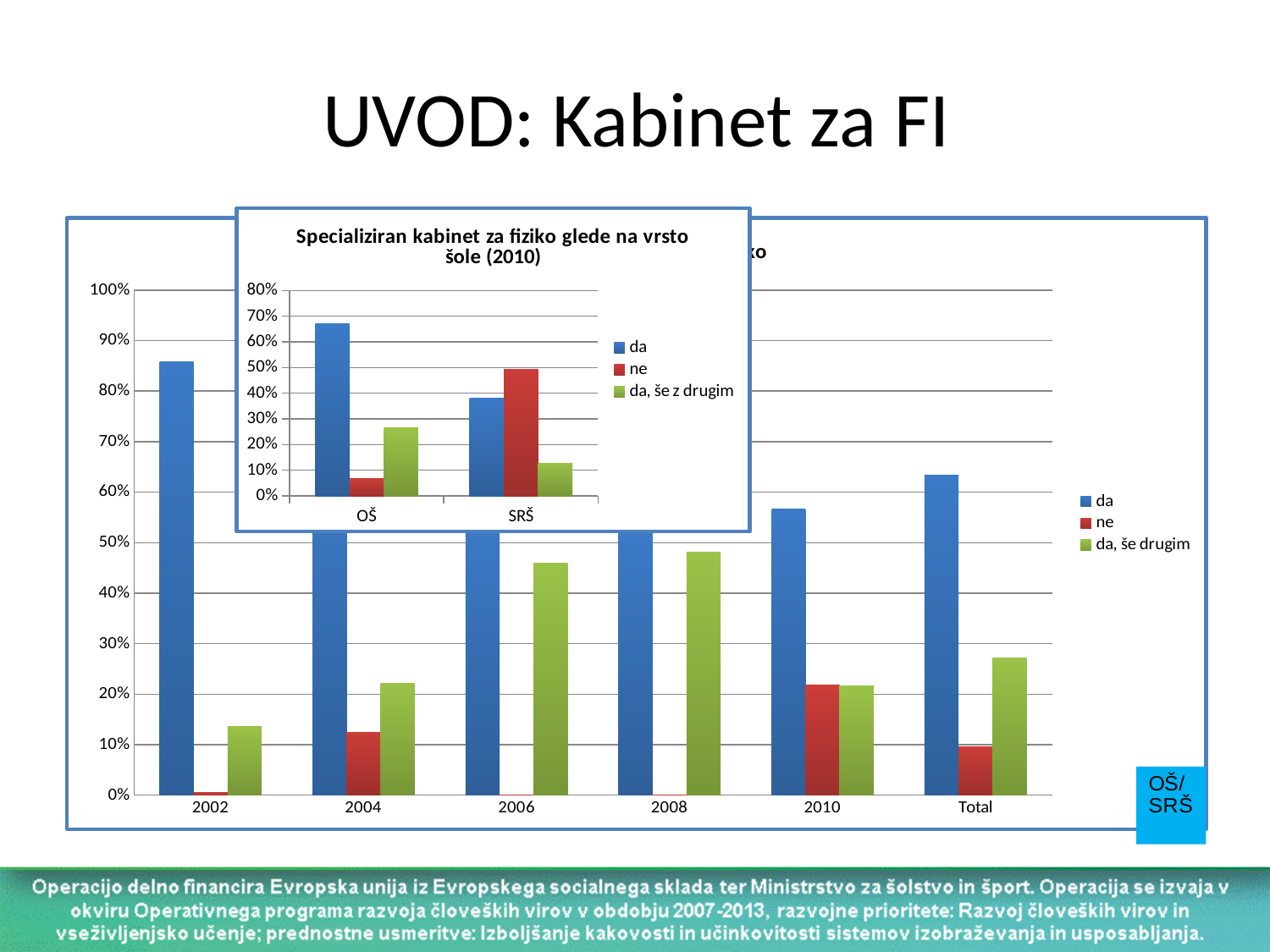
What type of chart is the inset chart titled "Specializiran kabinet za fiziko glede na vrsto šole (2010)"? bar chart In the large background chart, is the value for "da" in 2002 greater or less than 80%? greater How many categories are shown on the x axis of the inset chart "Specializiran kabinet za fiziko glede na vrsto šole (2010)"? 2 In the large background chart, is the value for "ne" in Total greater or less than 20%? less How many series does the legend of the inset chart "Specializiran kabinet za fiziko glede na vrsto šole (2010)" list? 3 In the inset chart "Specializiran kabinet za fiziko glede na vrsto šole (2010)", which is larger for SRŠ: "da" or "ne"? ne How many categories are shown on the x axis of the large background chart? 6 In the large background chart, which is larger: the "da" value for 2002 or the "da" value for 2010? 2002 In the inset chart "Specializiran kabinet za fiziko glede na vrsto šole (2010)", is the value for "da" at OŠ greater or less than 60%? greater In the large background chart, which year has the lowest value for "da, še z drugim"? 2002 In the inset chart "Specializiran kabinet za fiziko glede na vrsto šole (2010)", which category has the higher value for "ne"? SRŠ